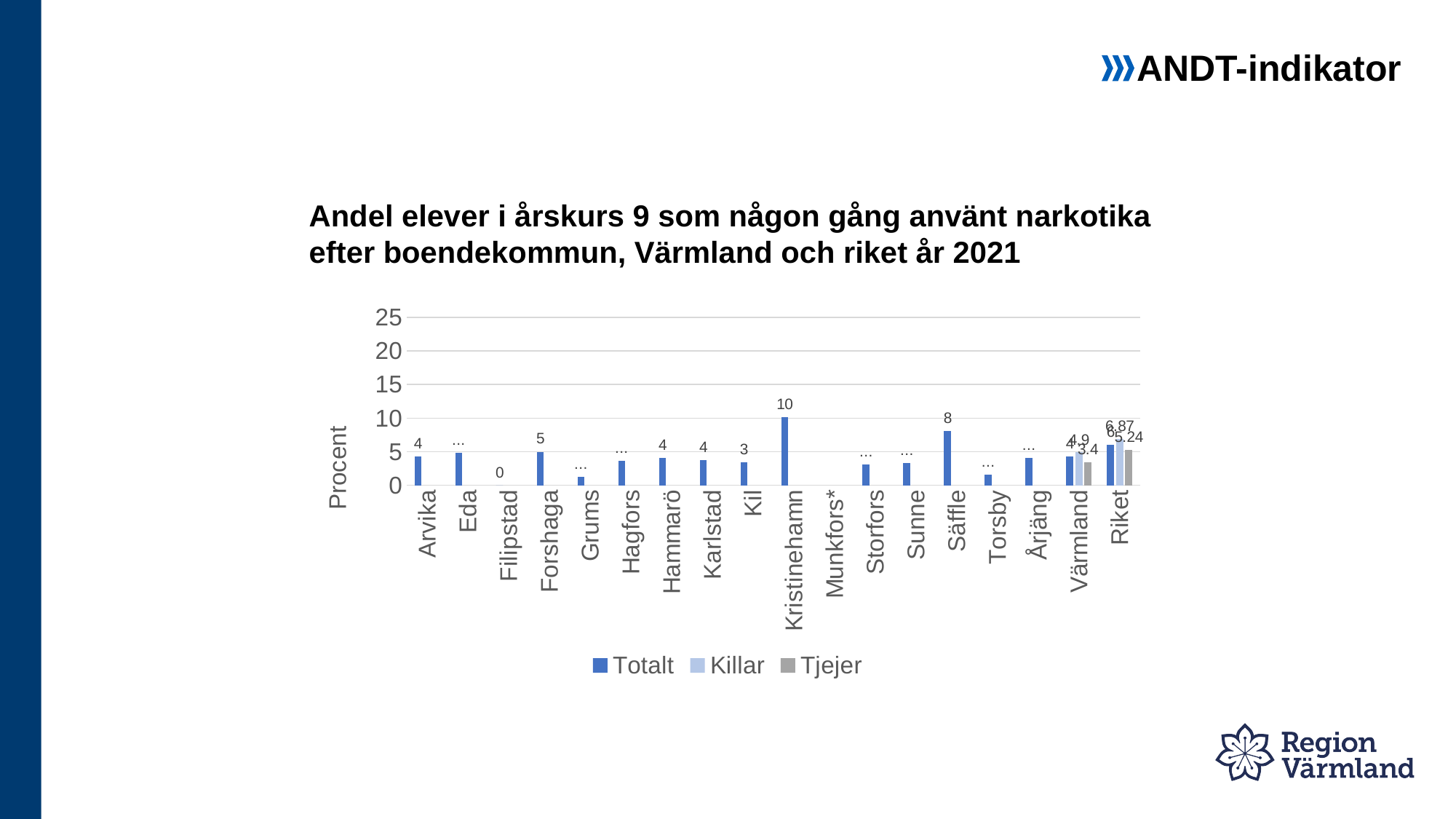
What is the Totalt value for Filipstad? 0 What is the Totalt value for Säffle? 8 Which has a higher Totalt value, Forshaga or Kil? Forshaga How many categories are shown on the x axis? 18 Is the Totalt value for Grums greater or less than 5? less What is the label on the y axis? Procent What is the difference between the Totalt values for Kristinehamn and Säffle? 2 How many series does the legend list? 3 Which municipality has the highest Totalt value? Kristinehamn What kind of chart is shown? bar chart What is the Tjejer value for Riket? 5.24 What is the Totalt value for Kristinehamn? 10